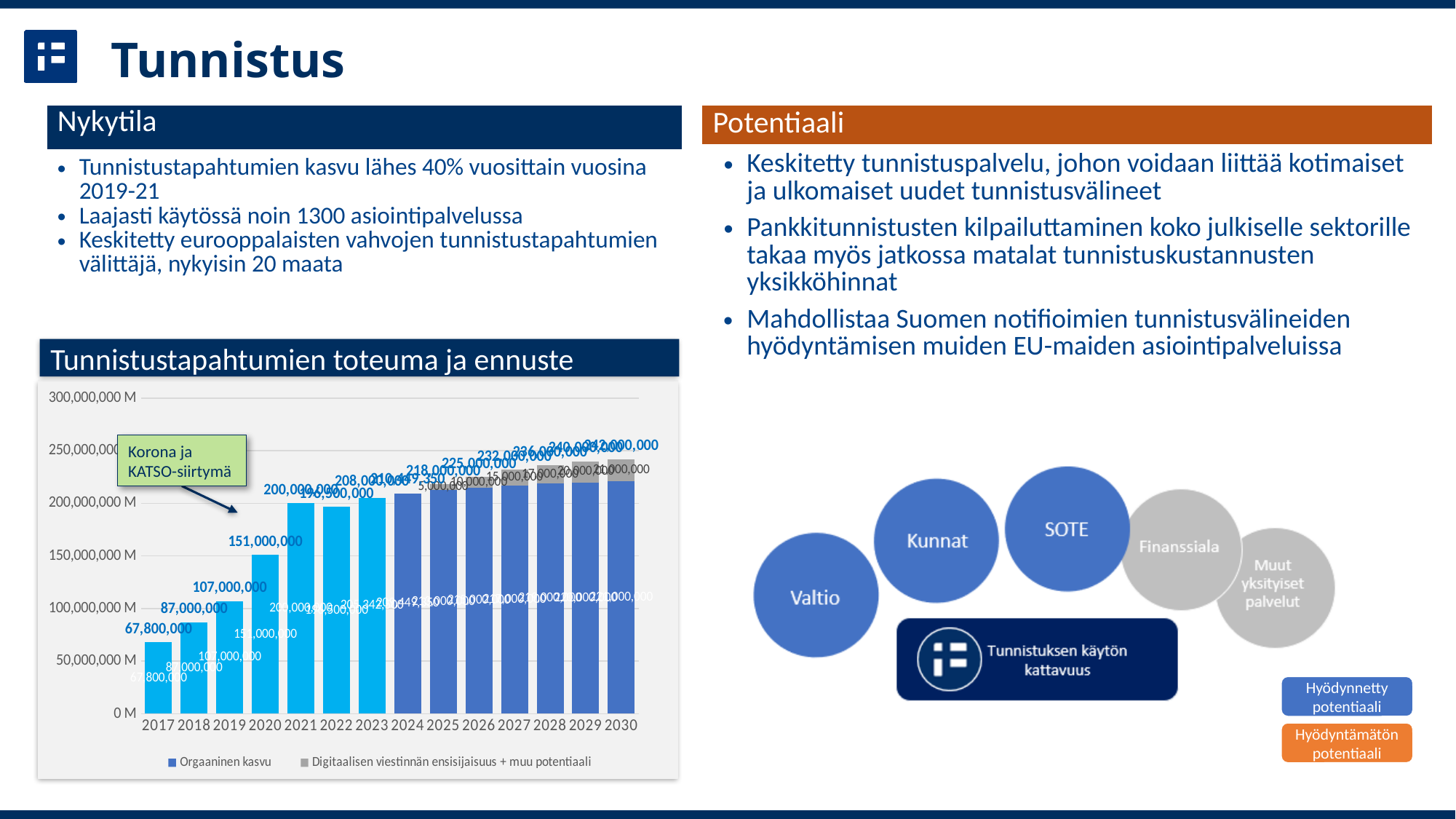
In the 'Tunnistustapahtumien toteuma ja ennuste' chart, what is the difference between the 2018 value and the 2017 value? 19,200,000 In the 'Tunnistustapahtumien toteuma ja ennuste' chart, is the total for 2030 greater or less than 200,000,000 M? greater What does the green annotation box on the 'Tunnistustapahtumien toteuma ja ennuste' chart say? Korona ja KATSO-siirtymä What kind of chart is 'Tunnistustapahtumien toteuma ja ennuste'? Stacked bar chart How many years are shown on the x axis of the 'Tunnistustapahtumien toteuma ja ennuste' chart? 14 What are the two legend entries of the 'Tunnistustapahtumien toteuma ja ennuste' chart? Orgaaninen kasvu; Digitaalisen viestinnän ensisijaisuus + muu potentiaali How many series does the legend of the 'Tunnistustapahtumien toteuma ja ennuste' chart list? 2 In the 'Tunnistustapahtumien toteuma ja ennuste' chart, what is the value labelled for 2017? 67,800,000 In the 'Tunnistustapahtumien toteuma ja ennuste' chart, which year has the lowest value? 2017 In the 'Tunnistustapahtumien toteuma ja ennuste' chart, what is the value labelled for 2022? 196,500,000 In the 'Tunnistustapahtumien toteuma ja ennuste' chart, what is the value labelled for 2020? 151,000,000 In the 'Tunnistustapahtumien toteuma ja ennuste' chart, what is the value labelled for 2019? 107,000,000